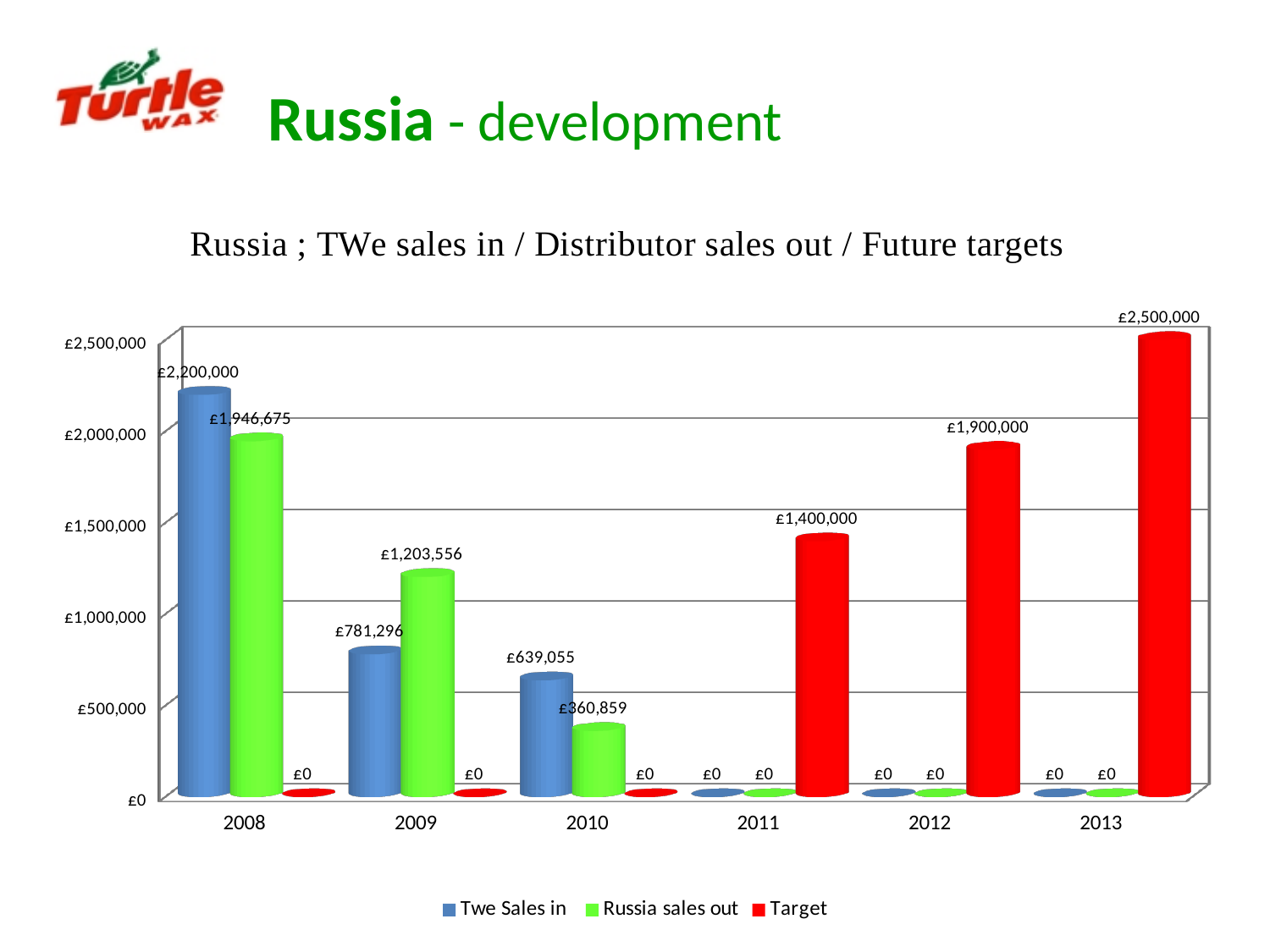
Which year has the lowest non-zero Twe Sales in value? 2010 What is the difference between Twe Sales in and Russia sales out in 2008? £253,325 How many years are shown on the x axis? 6 Does the Target value rise or fall from 2011 to 2013? Rise What kind of chart is shown on the slide? Bar chart How many series does the legend list? 3 Which year has the highest Target value? 2013 What is the Twe Sales in value for 2008? £2,200,000 What is the Russia sales out value for 2009? £1,203,556 What is the Target value for 2012? £1,900,000 Which is larger in 2009: Twe Sales in or Russia sales out? Russia sales out What is the Russia sales out value for 2010? £360,859